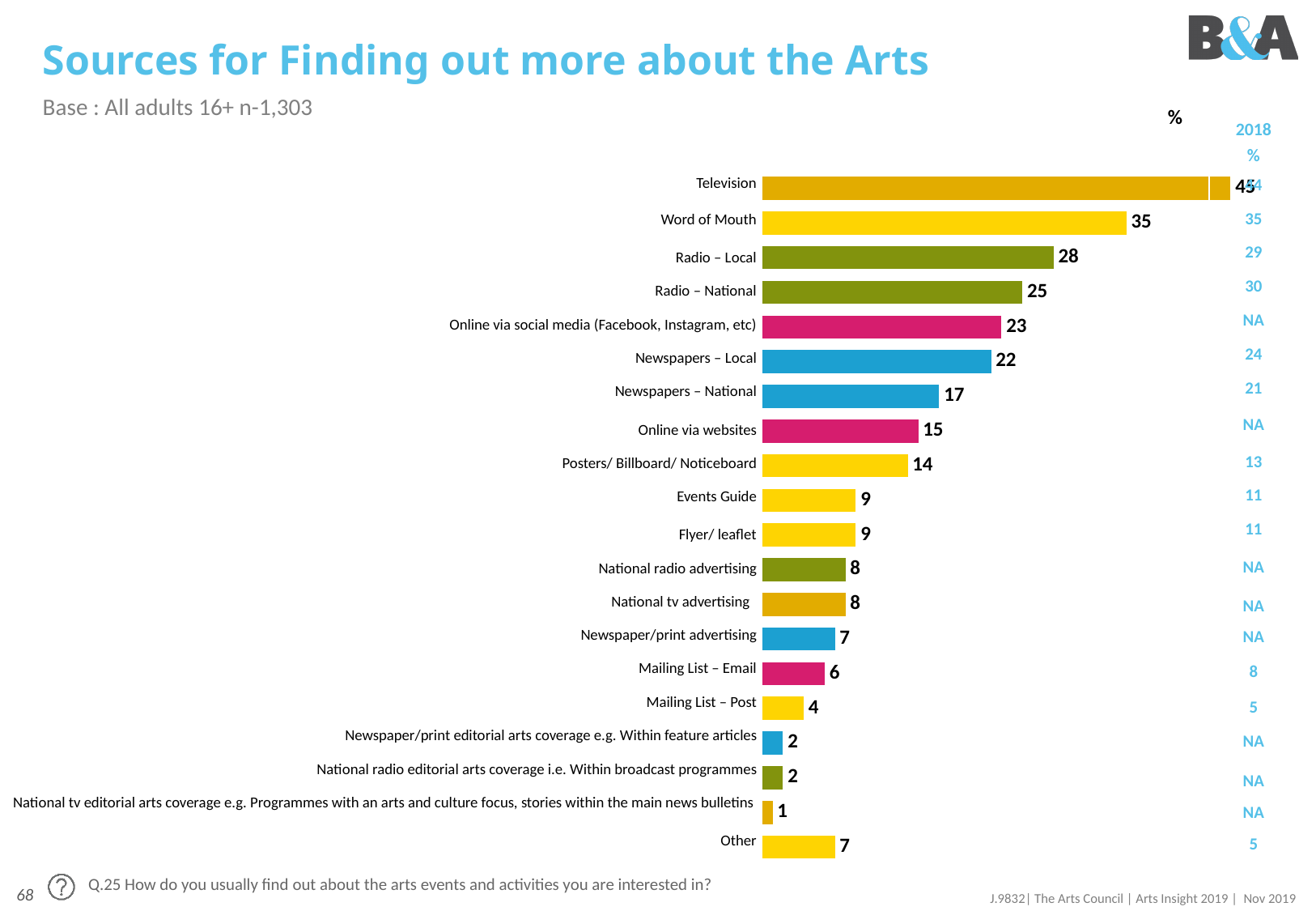
What is the difference between the values for Posters/ Billboard/ Noticeboard and Events Guide? 5 What is the title of the chart? Sources for Finding out more about the Arts Which source has the highest value? Television How many sources (categories) are plotted in the chart? 20 What is the difference between the values for Radio – Local and Radio – National? 3 Which source has the lowest value? National tv editorial arts coverage e.g. Programmes with an arts and culture focus, stories within the main news bulletins What is the value for Online via social media (Facebook, Instagram, etc)? 23 What kind of chart is shown on the slide? bar chart Which is larger, the value for Newspapers – Local or the value for Online via websites? Newspapers – Local What is the value for Newspapers – National? 17 What is the value for Word of Mouth? 35 What is the value for Mailing List – Post? 4